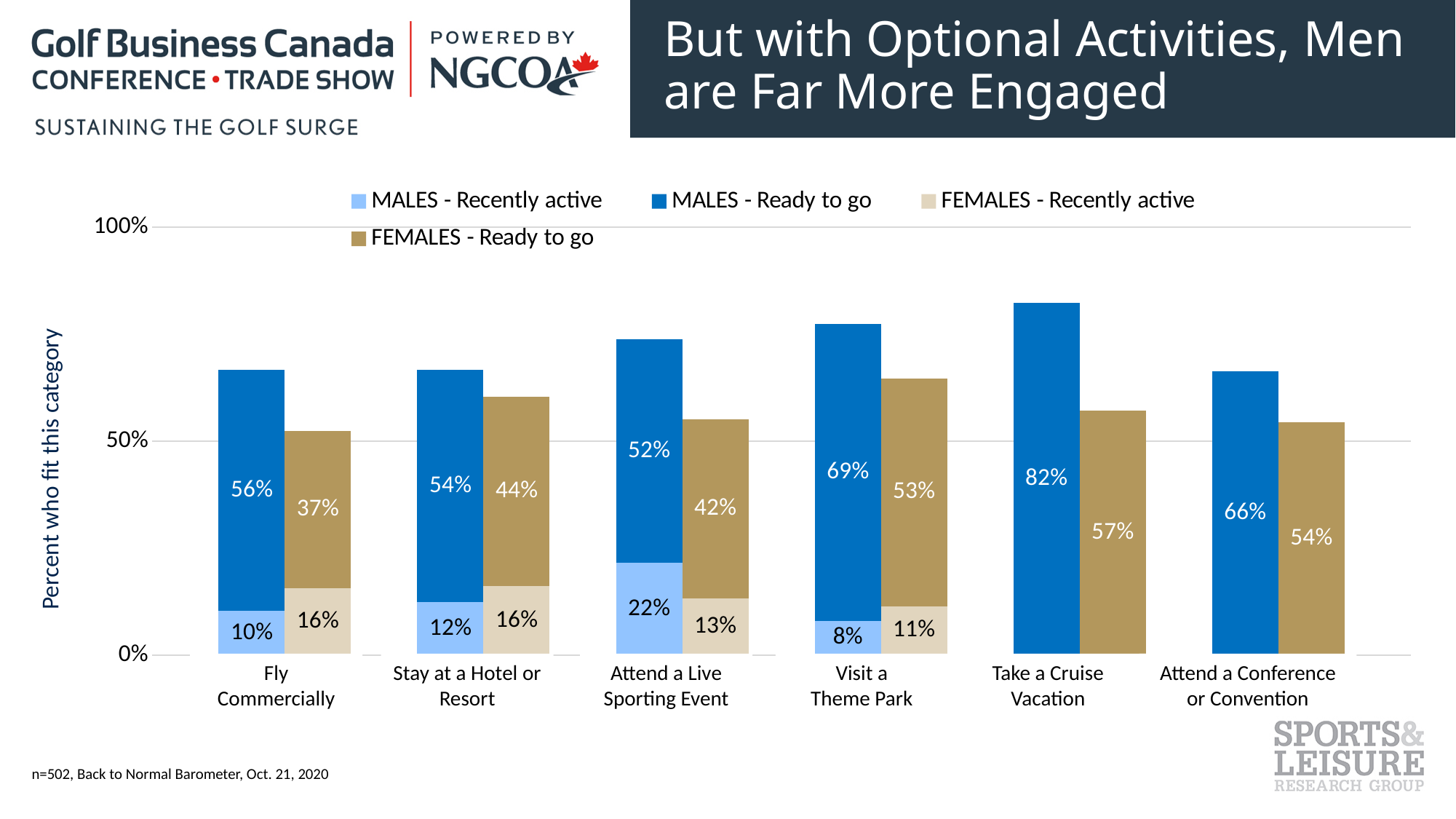
What is the value for MALES - Recently active for Visit a Theme Park? 8% Which activity has the lowest FEMALES - Ready to go value? Fly Commercially What is the value for MALES - Ready to go for Take a Cruise Vacation? 82% Which is larger for Fly Commercially: MALES - Recently active or FEMALES - Recently active? FEMALES - Recently active What is the total of the stacked male bar (Recently active plus Ready to go) for Attend a Live Sporting Event? 74% How many activity categories are shown on the x axis? 6 What is the label on the y axis? Percent who fit this category What is the value for FEMALES - Recently active for Attend a Live Sporting Event? 13% How many series does the legend list? 4 What is the difference between the MALES - Ready to go and FEMALES - Ready to go values for Take a Cruise Vacation? 25% Which activity has the highest MALES - Ready to go value? Take a Cruise Vacation What kind of chart is shown on the slide? Stacked bar chart